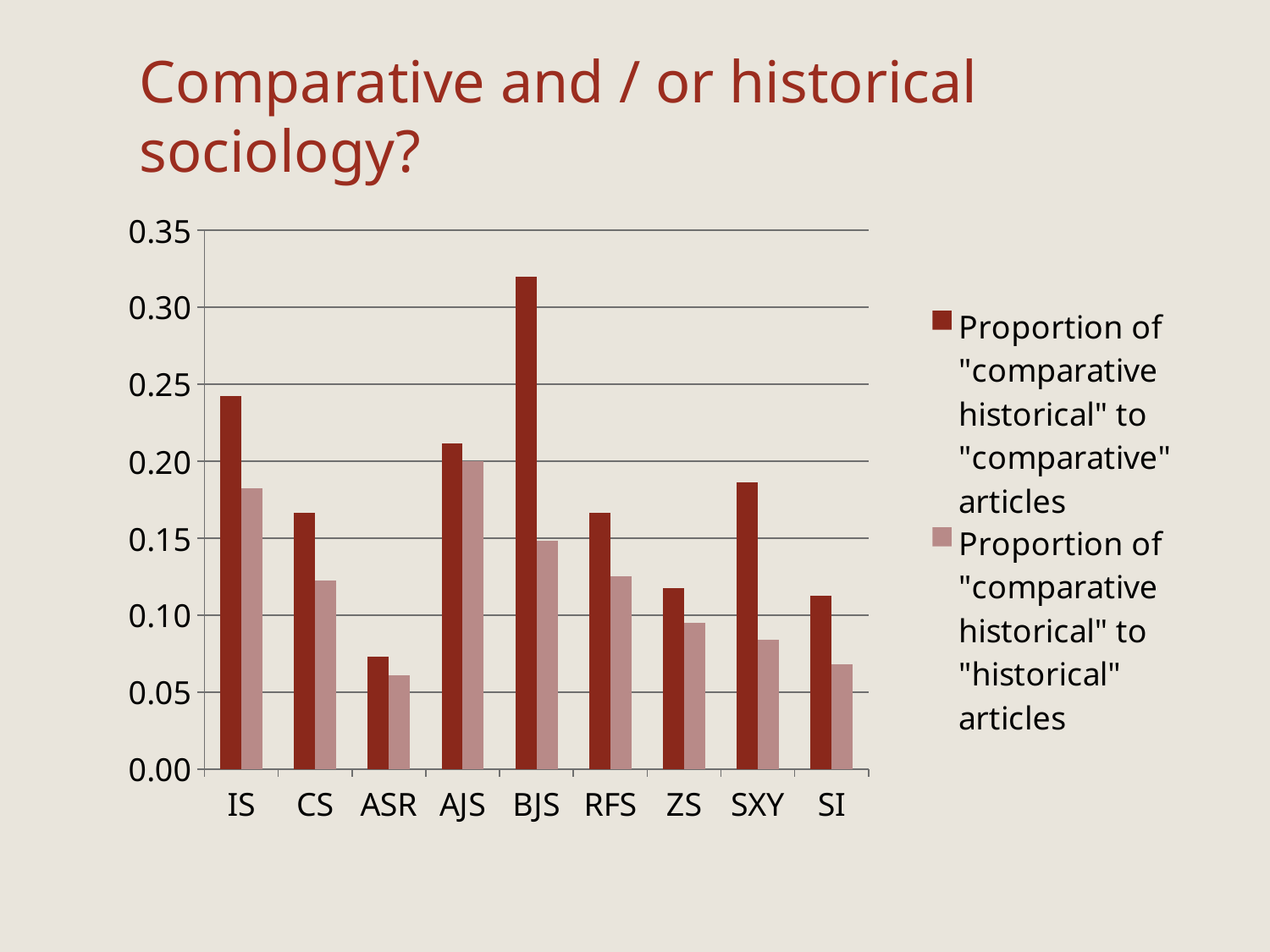
Is the proportion of "comparative historical" to "comparative" articles for ASR greater or less than 0.10? less What kind of chart is shown on the slide? bar chart How many journals (categories) are shown on the x axis? 9 Which journal has the lowest proportion of "comparative historical" to "comparative" articles? ASR Which colour represents the proportion of "comparative historical" to "historical" articles in the legend? light pink/brown Is the proportion of "comparative historical" to "comparative" articles for BJS greater or less than 0.30? greater For BJS, which is larger: the proportion of "comparative historical" to "comparative" articles or the proportion of "comparative historical" to "historical" articles? Proportion of "comparative historical" to "comparative" articles Which journal has the larger proportion of "comparative historical" to "comparative" articles, IS or CS? IS Is the proportion of "comparative historical" to "historical" articles for SXY greater or less than 0.10? less Which journal has the highest proportion of "comparative historical" to "comparative" articles? BJS How many series does the legend list? 2 Which journal has the lowest proportion of "comparative historical" to "historical" articles? ASR